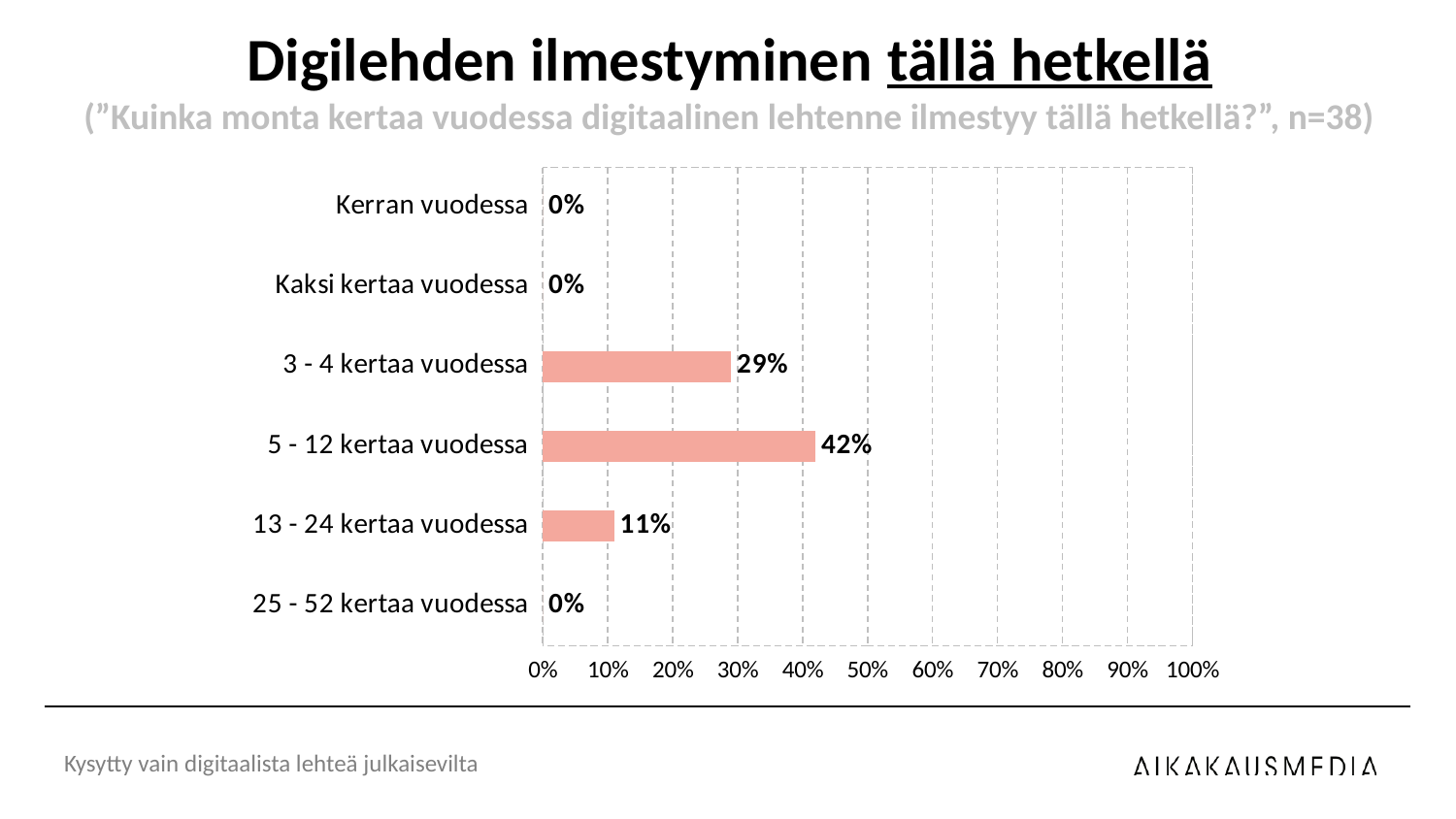
What is the value for "13 - 24 kertaa vuodessa"? 11% How many categories are shown on the chart? 6 How many categories have a value of 0%? 3 Which category has the highest value? 5 - 12 kertaa vuodessa What is the difference between the values for "5 - 12 kertaa vuodessa" and "3 - 4 kertaa vuodessa"? 13% What is the value for "3 - 4 kertaa vuodessa"? 29% What is the value for "Kerran vuodessa"? 0% What is the value for "5 - 12 kertaa vuodessa"? 42% Is the value for "5 - 12 kertaa vuodessa" greater or less than 40%? greater What kind of chart is shown on the slide? bar chart Which is larger, the value for "3 - 4 kertaa vuodessa" or "13 - 24 kertaa vuodessa"? 3 - 4 kertaa vuodessa What is the difference between the values for "3 - 4 kertaa vuodessa" and "13 - 24 kertaa vuodessa"? 18%